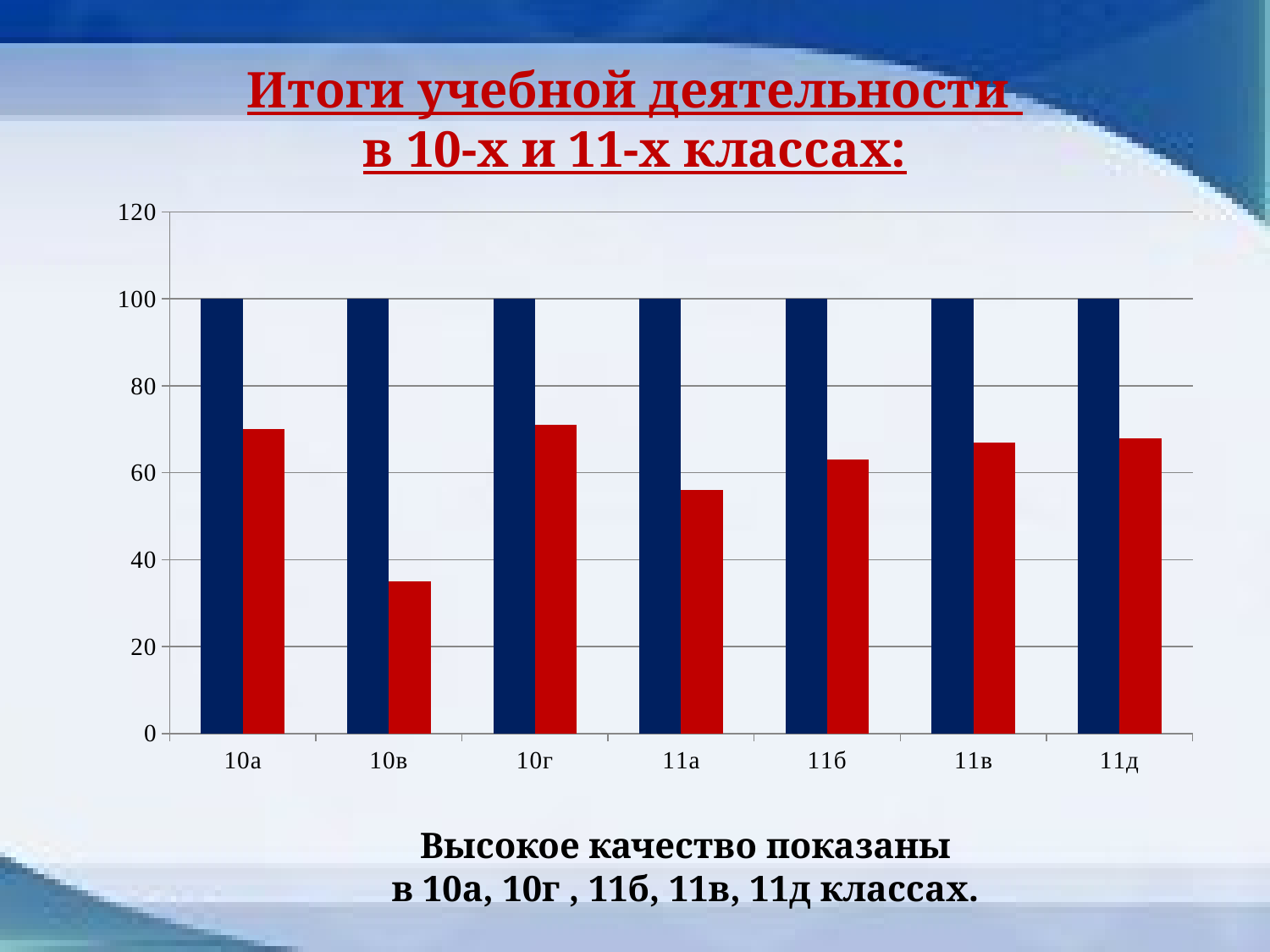
Which class has the larger red bar, 10а or 10в? 10а Is the value of the red bar for class 10в greater or less than 40? less How many classes (categories) are shown on the x axis of the chart? 7 How many bars are shown for each class in the chart? 2 Is the value of the red bar for class 11а greater or less than 60? less Which class has the lowest red bar in the chart? 10в What is the value of the dark blue bar for class 10а? 100 Is the value of the red bar for class 10а greater or less than 60? greater What kind of chart is shown on the slide? bar chart What is the value of the dark blue bar for class 11д? 100 What is the title of the slide containing the chart? Итоги учебной деятельности в 10-х и 11-х классах: